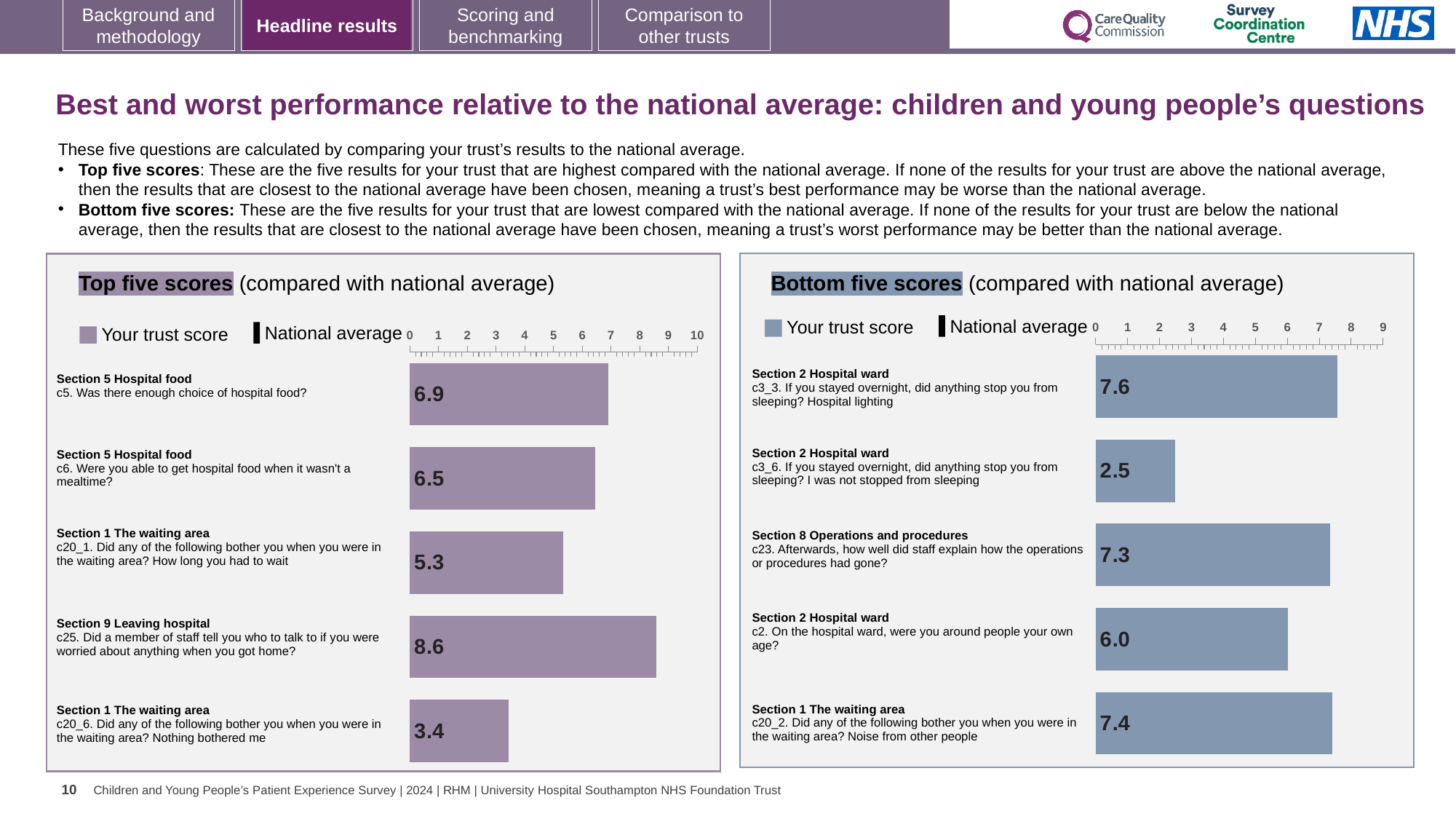
In the Bottom five scores chart, which question has the lowest trust score? c3_6. If you stayed overnight, did anything stop you from sleeping? I was not stopped from sleeping In the Bottom five scores chart, what is the trust score for c3_6 (I was not stopped from sleeping)? 2.5 In the Top five scores chart, what is the trust score for c5 (Was there enough choice of hospital food?)? 6.9 In the Bottom five scores chart, which has the larger trust score: c3_3 (Hospital lighting) or c23 (how well did staff explain how the operations or procedures had gone)? c3_3 (Hospital lighting) What kind of chart is the Top five scores chart? Bar chart In the Top five scores chart, which question has the highest trust score? c25. Did a member of staff tell you who to talk to if you were worried about anything when you got home? In the Top five scores chart, which question has the lowest trust score? c20_6. Did any of the following bother you when you were in the waiting area? Nothing bothered me In the Top five scores chart, what is the difference between the highest trust score (8.6) and the lowest trust score (3.4)? 5.2 How many series does the legend of the Top five scores chart list? 2 In the Bottom five scores chart, what is the trust score for c2 (On the hospital ward, were you around people your own age?)? 6.0 How many questions are shown in the Bottom five scores chart? 5 In the Top five scores chart, what is the trust score for c25 (Did a member of staff tell you who to talk to if you were worried about anything when you got home?)? 8.6